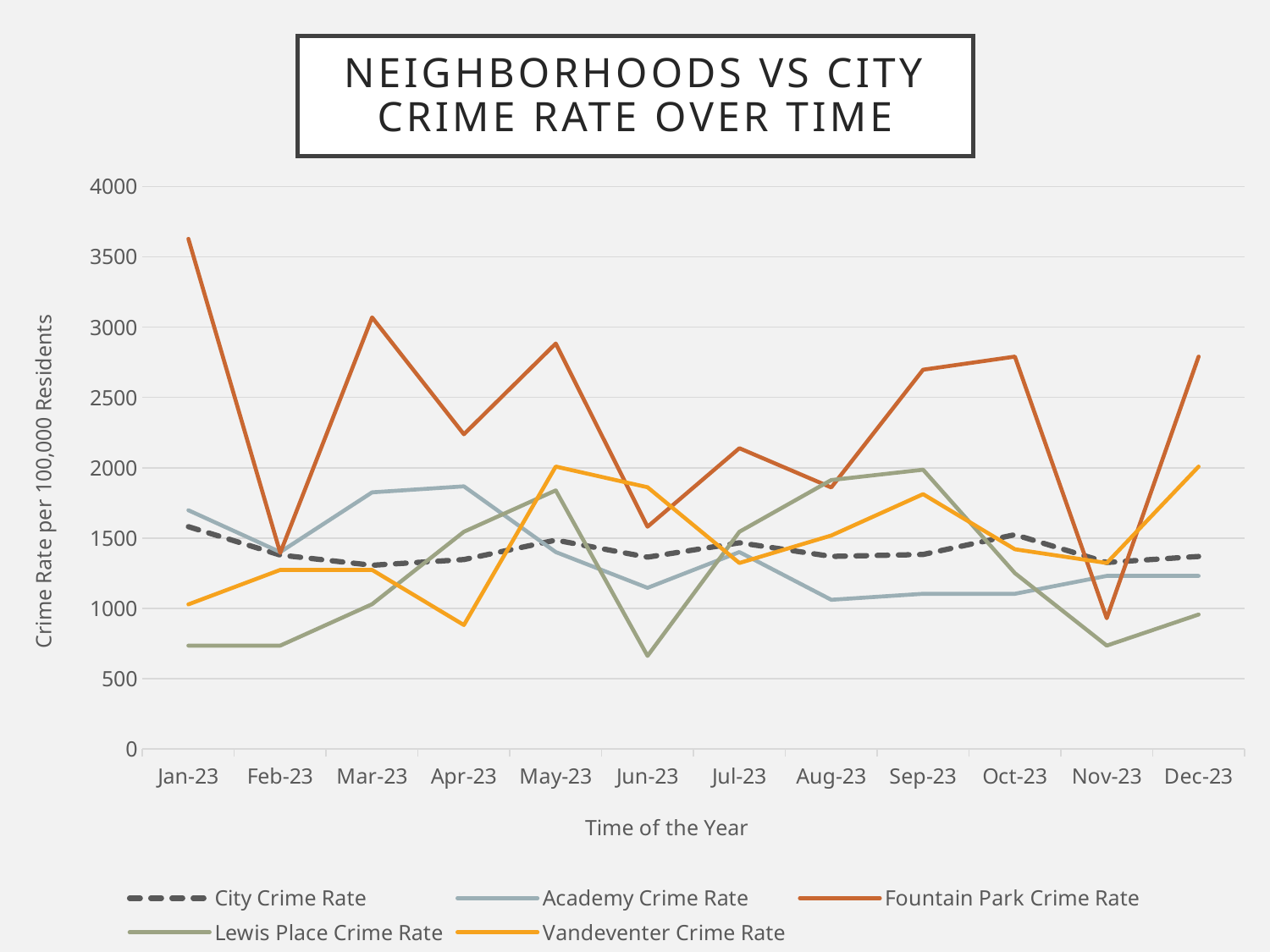
In Jan-23, which is higher, the Academy Crime Rate or the Vandeventer Crime Rate? Academy Crime Rate Which series is drawn with a dashed line? City Crime Rate In which month is the Fountain Park Crime Rate highest? Jan-23 How many months are shown along the x axis? 12 What kind of chart is shown on the slide? line chart Is the Vandeventer Crime Rate in Apr-23 greater or less than 1000? less Is the Fountain Park Crime Rate in Jan-23 greater or less than 3500? greater In which month is the Fountain Park Crime Rate lowest? Nov-23 How many series does the legend list? 5 In Sep-23, which is higher, the Fountain Park Crime Rate or the City Crime Rate? Fountain Park Crime Rate In which month is the Lewis Place Crime Rate lowest? Jun-23 Does the Fountain Park Crime Rate rise or fall from Jan-23 to Feb-23? fall